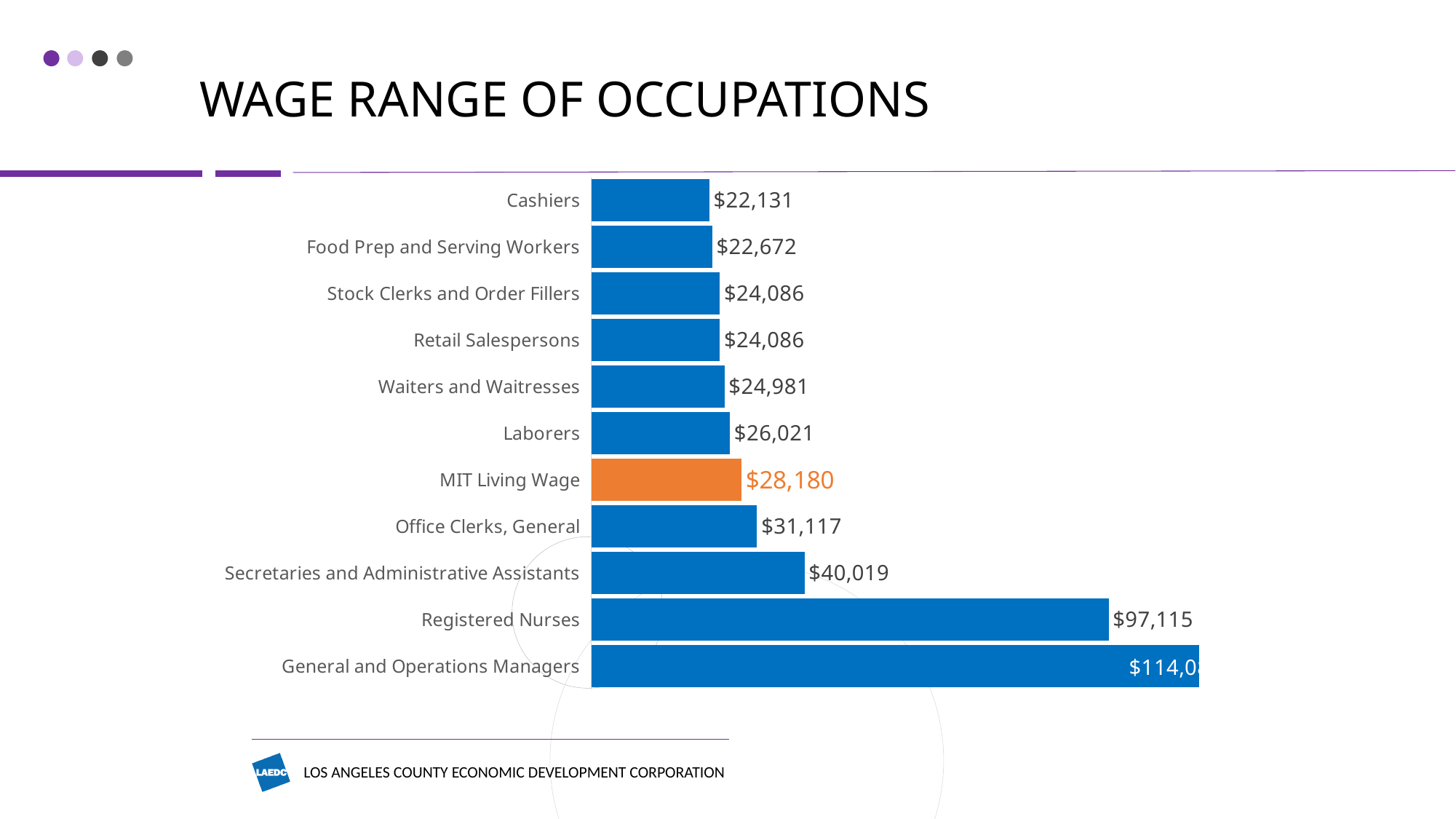
What type of chart is shown on the slide? Bar chart What is the wage shown for Waiters and Waitresses? $24,981 What is the difference between the wage for Office Clerks, General and the MIT Living Wage? $2,937 Which is larger, the wage for Laborers or the wage for Food Prep and Serving Workers? Laborers Which occupation has the lowest wage on the chart? Cashiers What is the value of the MIT Living Wage bar? $28,180 What is the wage shown for Registered Nurses? $97,115 Which occupation has the highest wage on the chart? General and Operations Managers How many bars are shown on the chart? 11 What is the wage shown for Secretaries and Administrative Assistants? $40,019 Which bar on the chart is coloured orange instead of blue? MIT Living Wage What is the wage shown for Cashiers? $22,131